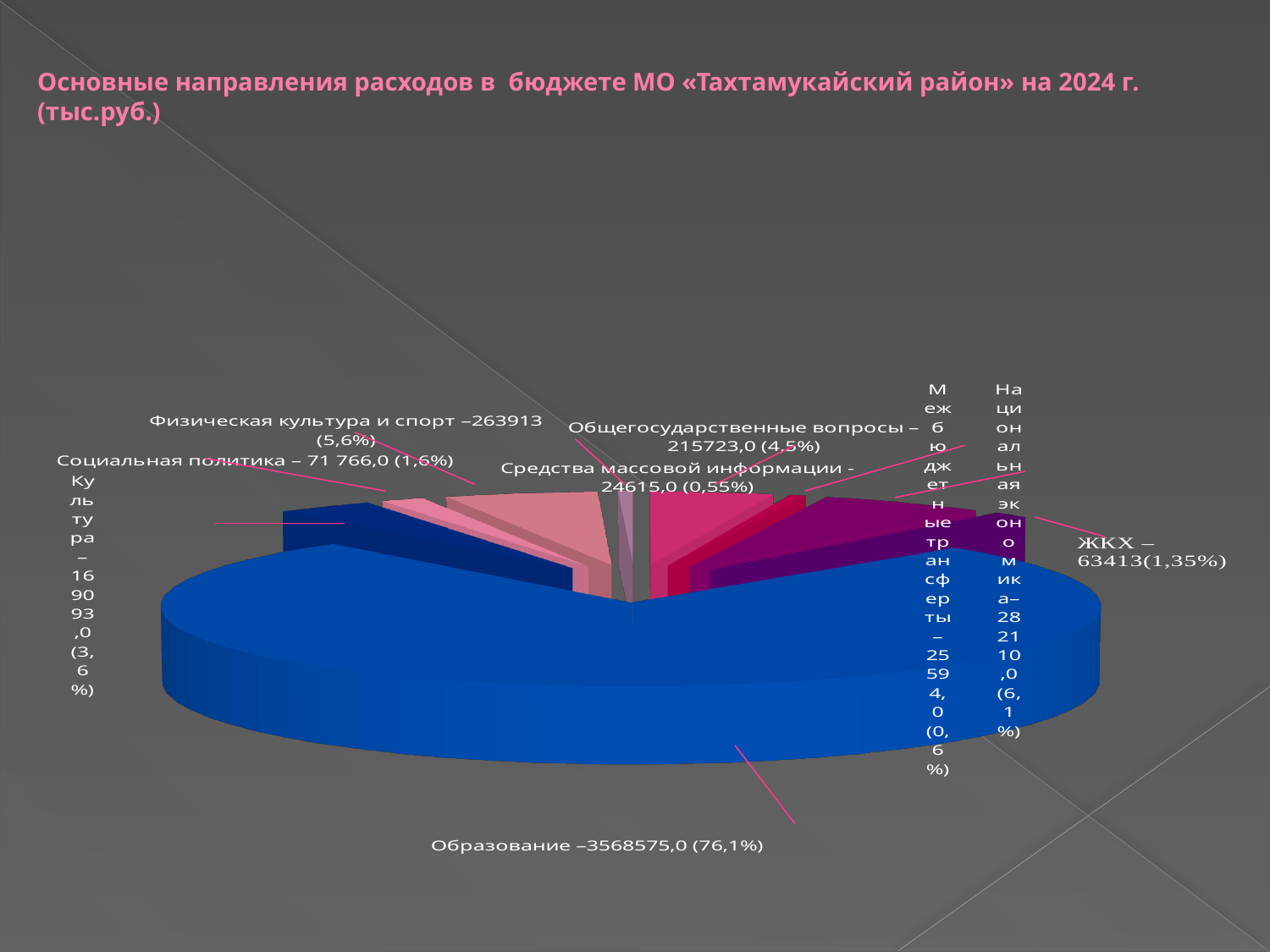
What is the value shown for Образование? 3568575,0 What is the title of the chart? Основные направления расходов в бюджете МО «Тахтамукайский район» на 2024 г. (тыс.руб.) Which category has the smallest share of the budget expenditures? Средства массовой информации Which is larger: the value for Физическая культура и спорт or the value for Социальная политика? Физическая культура и спорт What is the difference between the value for Физическая культура и спорт and the value for ЖКХ? 200500 What kind of chart is shown on the slide? Pie chart What is the value shown for Общегосударственные вопросы? 215723,0 How many categories (slices) does the pie chart show? 9 Which category has the largest share of the budget expenditures? Образование What share of the pie does Физическая культура и спорт represent? 5,6% What is the value shown for ЖКХ? 63413 What share of the pie does Образование represent? 76,1%